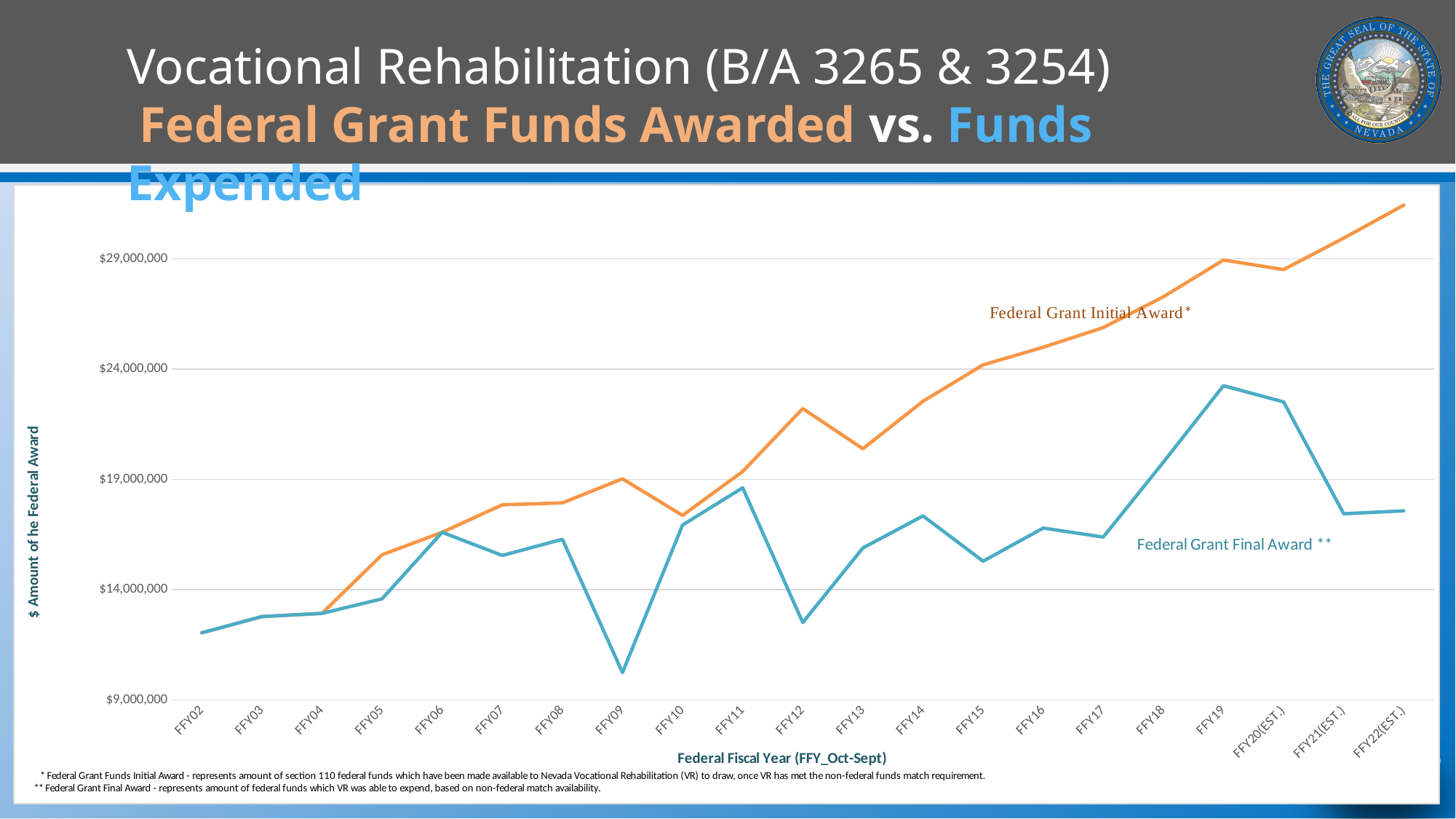
Is the Federal Grant Final Award for FFY19 greater or less than $19,000,000? greater How many data series are plotted on the chart? 2 Does the Federal Grant Initial Award generally rise or fall from FFY02 to FFY22(EST.)? Rise Is the Federal Grant Final Award for FFY09 greater or less than $14,000,000? less For FFY19, which is larger: the Federal Grant Initial Award or the Federal Grant Final Award? Federal Grant Initial Award In which federal fiscal year is the Federal Grant Final Award highest? FFY19 In which federal fiscal year is the Federal Grant Final Award lowest? FFY09 In which federal fiscal year is the Federal Grant Initial Award highest? FFY22(EST.) What kind of chart is shown on the slide? Line chart How many federal fiscal years are shown along the x axis? 21 What is the title of the x axis? Federal Fiscal Year (FFY_Oct-Sept) Is the Federal Grant Initial Award for FFY22(EST.) greater or less than $29,000,000? greater